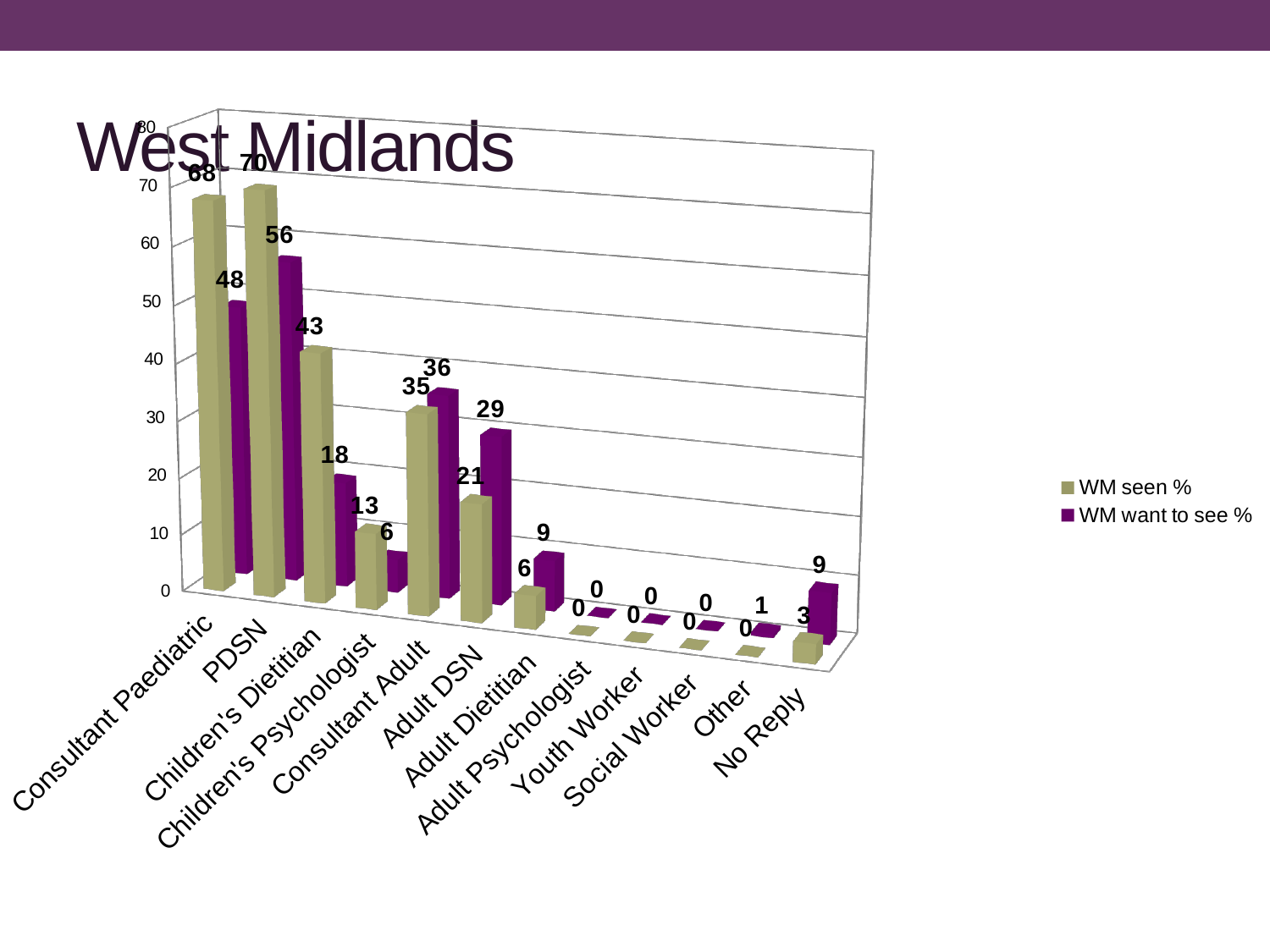
What is the difference between the WM seen % and WM want to see % values for Consultant Paediatric? 20 What kind of chart is shown on the slide? Bar chart Which category has the highest WM want to see % value? PDSN What is the WM seen % value for Children's Dietitian? 43 How many categories are shown on the x axis? 12 What is the difference between the WM seen % and WM want to see % values for Children's Dietitian? 25 What is the WM seen % value for PDSN? 70 How many series does the legend list? 2 What is the title of the slide? West Midlands Which category has the highest WM seen % value? PDSN For Adult DSN, which is larger: WM seen % or WM want to see %? WM want to see % What is the WM want to see % value for Adult DSN? 29